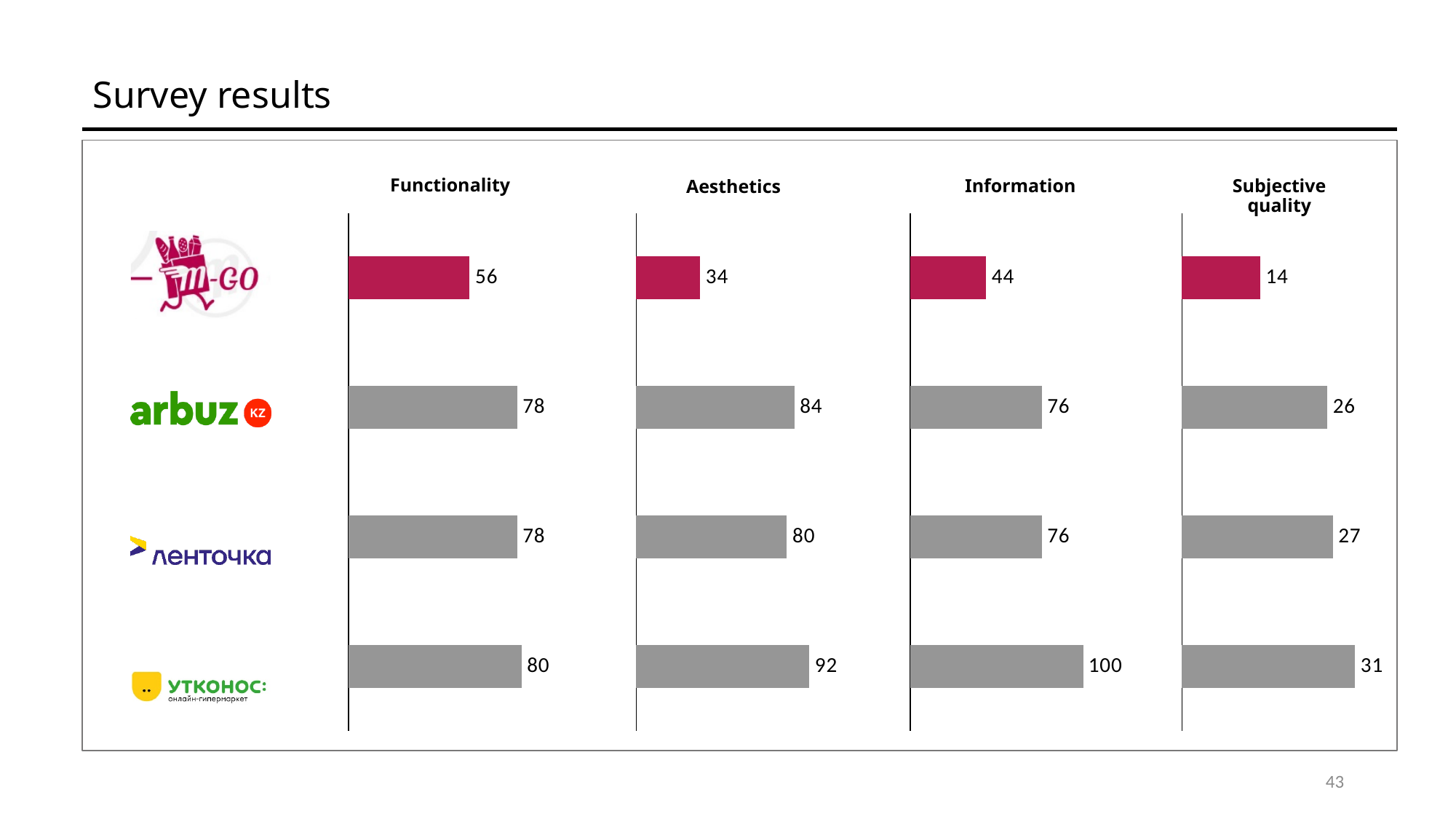
In the Information chart, which row has the highest value? Утконос How many separate charts are shown on the slide? 4 How many rows (brands) are plotted in each chart? 4 In the Functionality chart, what is the difference between the values for Утконос and the top row (Ш-GO)? 24 In the Aesthetics chart, which is larger: the value for arbuz.kz or the value for Ленточка? arbuz.kz In the Subjective quality chart, what is the difference between the values for Утконос and arbuz.kz? 5 In the Functionality chart, what is the value for Утконос? 80 In the Aesthetics chart, which row has the lowest value? The top row (Ш-GO) What kind of chart is used for the Functionality panel? Bar chart In the Subjective quality chart, what is the value for Ленточка? 27 In the Information chart, what is the value for the top row (the Ш-GO logo)? 44 In the Aesthetics chart, what is the value for arbuz.kz? 84